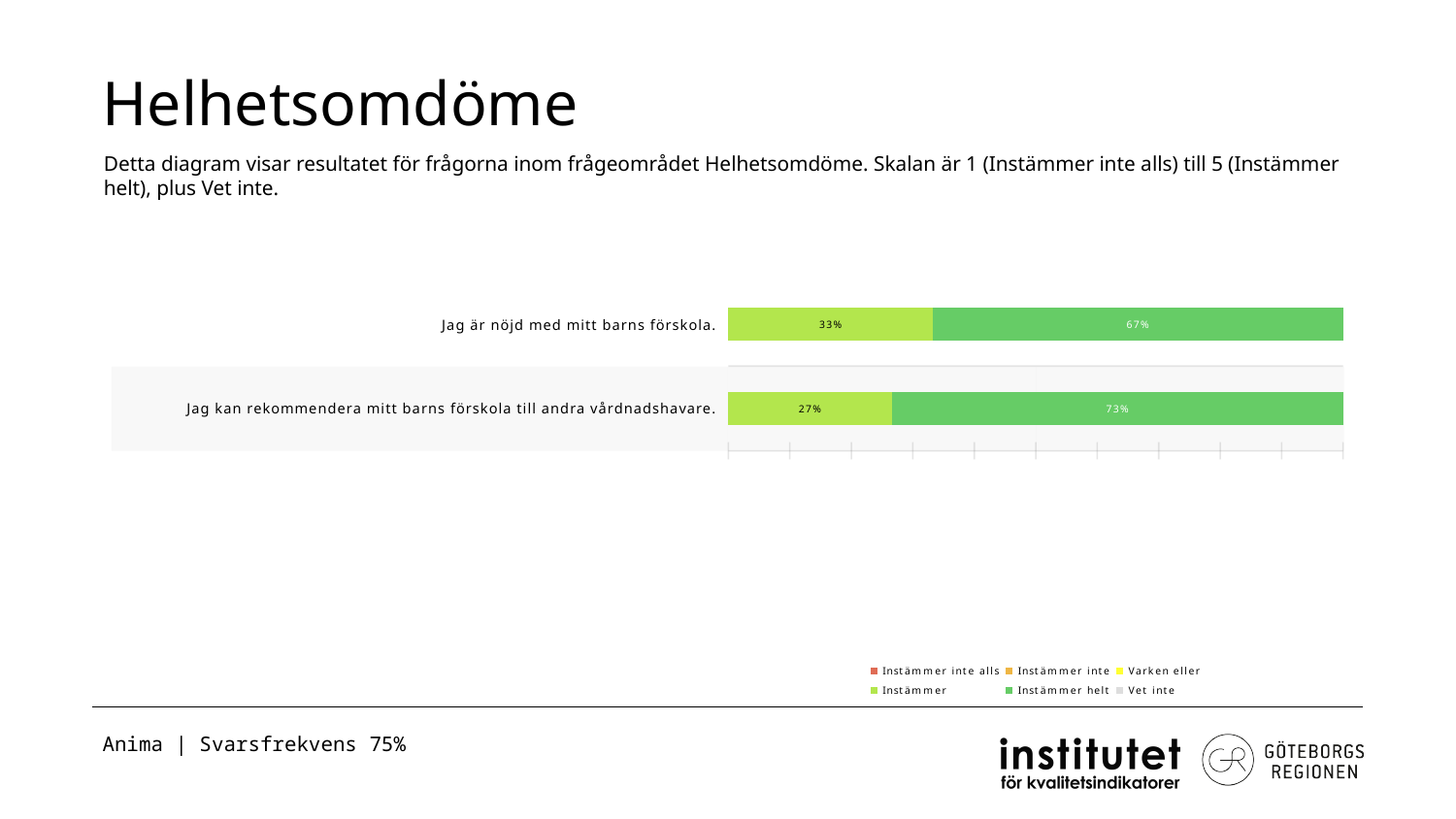
What percentage of respondents answered "Instämmer" for "Jag är nöjd med mitt barns förskola."? 33% Which statement has the lower share of "Instämmer" responses? Jag kan rekommendera mitt barns förskola till andra vårdnadshavare. What percentage of respondents answered "Instämmer helt" for "Jag kan rekommendera mitt barns förskola till andra vårdnadshavare."? 73% What is the combined total of "Instämmer" and "Instämmer helt" for "Jag kan rekommendera mitt barns förskola till andra vårdnadshavare."? 100% How many series does the legend list? 6 For "Jag är nöjd med mitt barns förskola.", which is larger: the "Instämmer" share or the "Instämmer helt" share? Instämmer helt What kind of chart is shown on the slide? Stacked horizontal bar chart How many statements (categories) are shown in the chart? 2 What is the difference between the "Instämmer helt" shares of the two statements? 6 percentage points What percentage of respondents answered "Instämmer helt" for "Jag är nöjd med mitt barns förskola."? 67% Which statement has the higher share of "Instämmer helt" responses? Jag kan rekommendera mitt barns förskola till andra vårdnadshavare. What percentage of respondents answered "Instämmer" for "Jag kan rekommendera mitt barns förskola till andra vårdnadshavare."? 27%